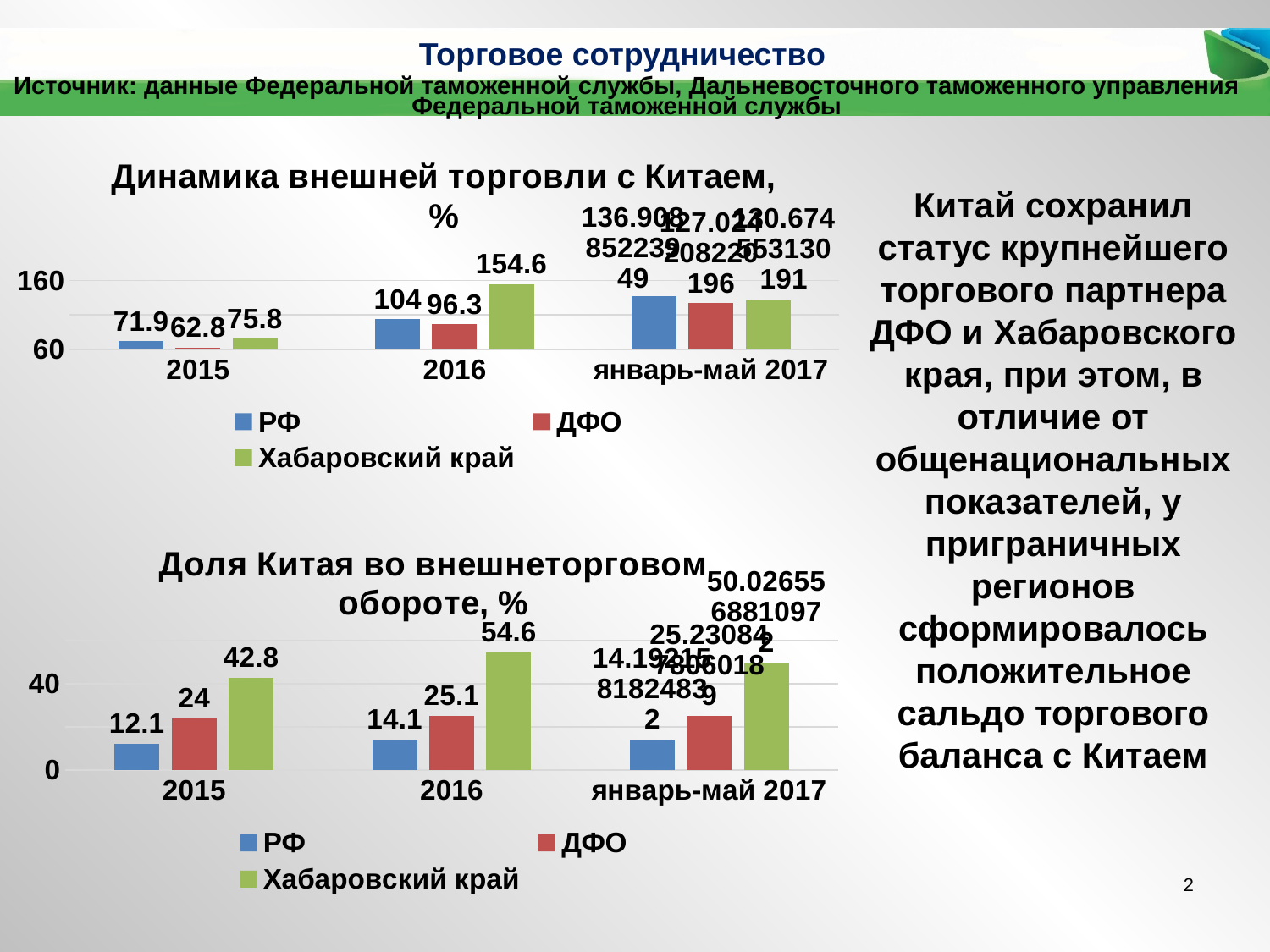
In the chart 'Динамика внешней торговли с Китаем, %', what is the difference between the values for РФ and ДФО in 2015? 9.1 In the chart 'Доля Китая во внешнеторговом обороте, %', what is the value for Хабаровский край in 2016? 54.6 In the chart 'Доля Китая во внешнеторговом обороте, %', is the value for Хабаровский край in 2016 greater or less than 40? greater In the chart 'Доля Китая во внешнеторговом обороте, %', what is the value for ДФО in 2015? 24 In the chart 'Динамика внешней торговли с Китаем, %', how many series does the legend list? 3 In the chart 'Доля Китая во внешнеторговом обороте, %', which series has the lowest value in 2015? РФ What kind of chart is 'Доля Китая во внешнеторговом обороте, %'? bar chart In the chart 'Динамика внешней торговли с Китаем, %', what is the value for Хабаровский край in 2016? 154.6 In the chart 'Доля Китая во внешнеторговом обороте, %', does the value for РФ rise or fall from 2015 to 2016? rise In the chart 'Динамика внешней торговли с Китаем, %', what is the value for РФ in 2015? 71.9 In the chart 'Динамика внешней торговли с Китаем, %', what is the value for ДФО in 2016? 96.3 In the chart 'Динамика внешней торговли с Китаем, %', which series has the highest value in 2016? Хабаровский край